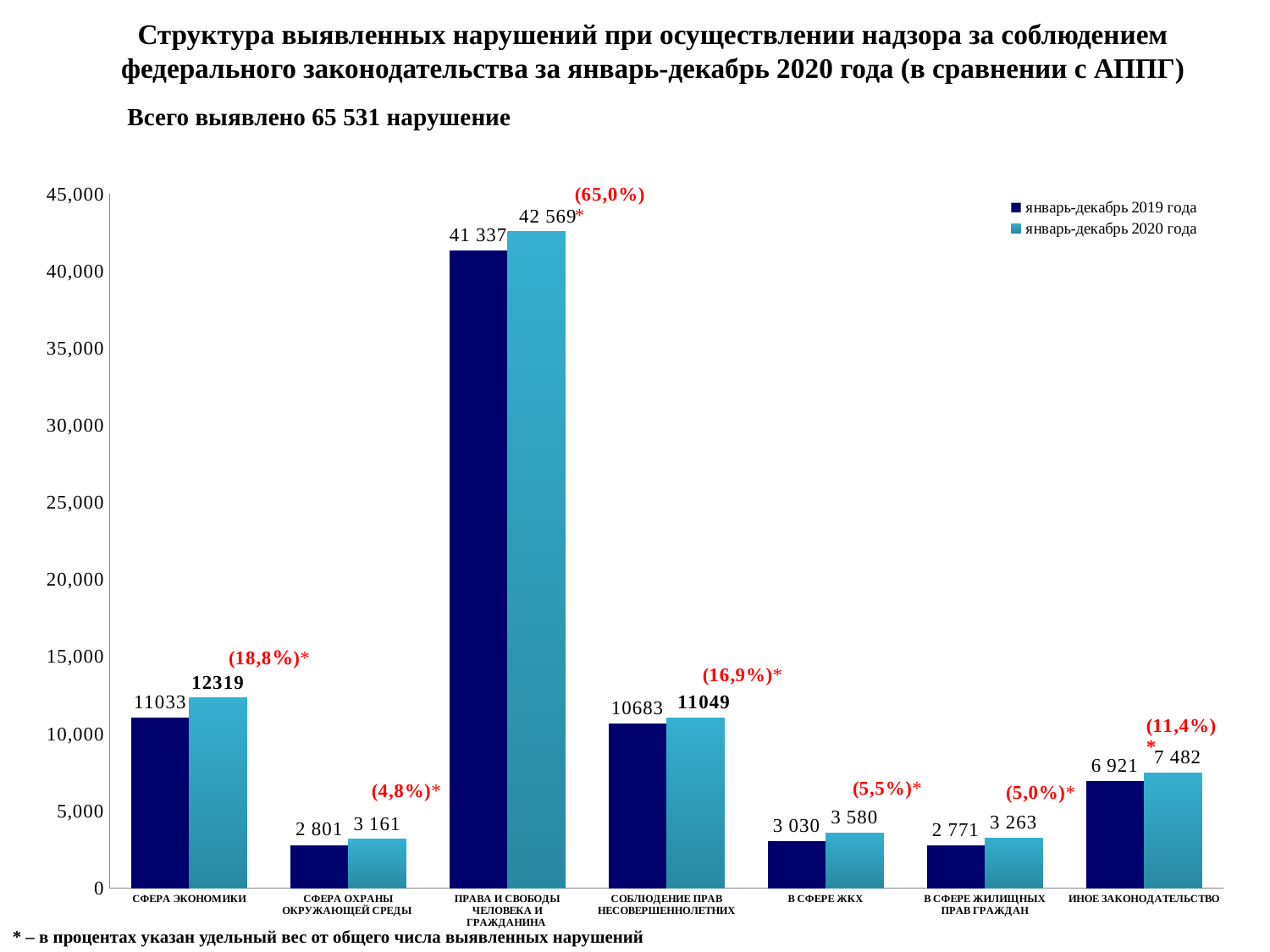
Which category has the highest value in the "январь-декабрь 2020 года" series? Права и свободы человека и гражданина How many categories are shown on the x axis? 7 What total number of violations is stated on the slide? 65 531 How many series does the legend list? 2 What kind of chart is shown on the slide? Bar chart What share of the total number of violations does "Права и свободы человека и гражданина" account for, according to the red label? 65,0% Which category has the lowest value in the "январь-декабрь 2019 года" series? В сфере жилищных прав граждан What is the value for "Сфера экономики" in the "январь-декабрь 2020 года" series? 12319 What is the value for "Права и свободы человека и гражданина" in the "январь-декабрь 2019 года" series? 41 337 What is the difference between the 2020 and 2019 values for "Иное законодательство"? 561 What is the value for "В сфере ЖКХ" in the "январь-декабрь 2020 года" series? 3 580 Which is larger for "Соблюдение прав несовершеннолетних": the 2019 value or the 2020 value? 2020 value (11049)